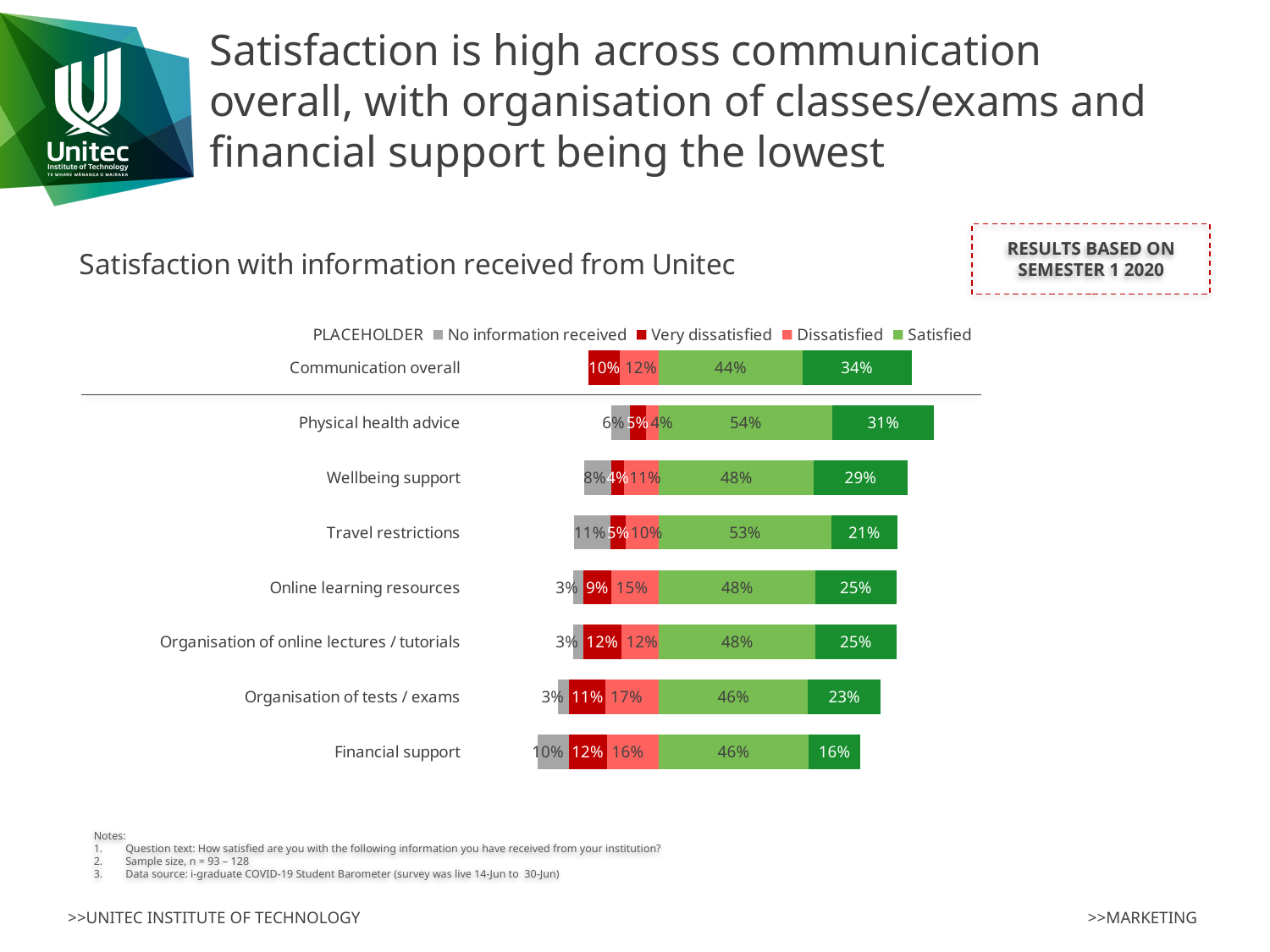
Which category has the lowest Dissatisfied value? Physical health advice What is the No information received value for Travel restrictions? 11% What is the Very dissatisfied value for Communication overall? 10% What is the Satisfied value for Physical health advice? 54% What is the Dissatisfied value for Organisation of tests / exams? 17% Which category has the highest Satisfied value? Physical health advice What type of chart is shown on the slide? Stacked bar chart Which category has the lowest Satisfied value? Communication overall Which has a larger Dissatisfied value, Financial support or Online learning resources? Financial support What is the difference between the Satisfied values for Physical health advice and Communication overall? 10 percentage points How many categories are shown in the chart? 8 What is the title of the chart? Satisfaction with information received from Unitec